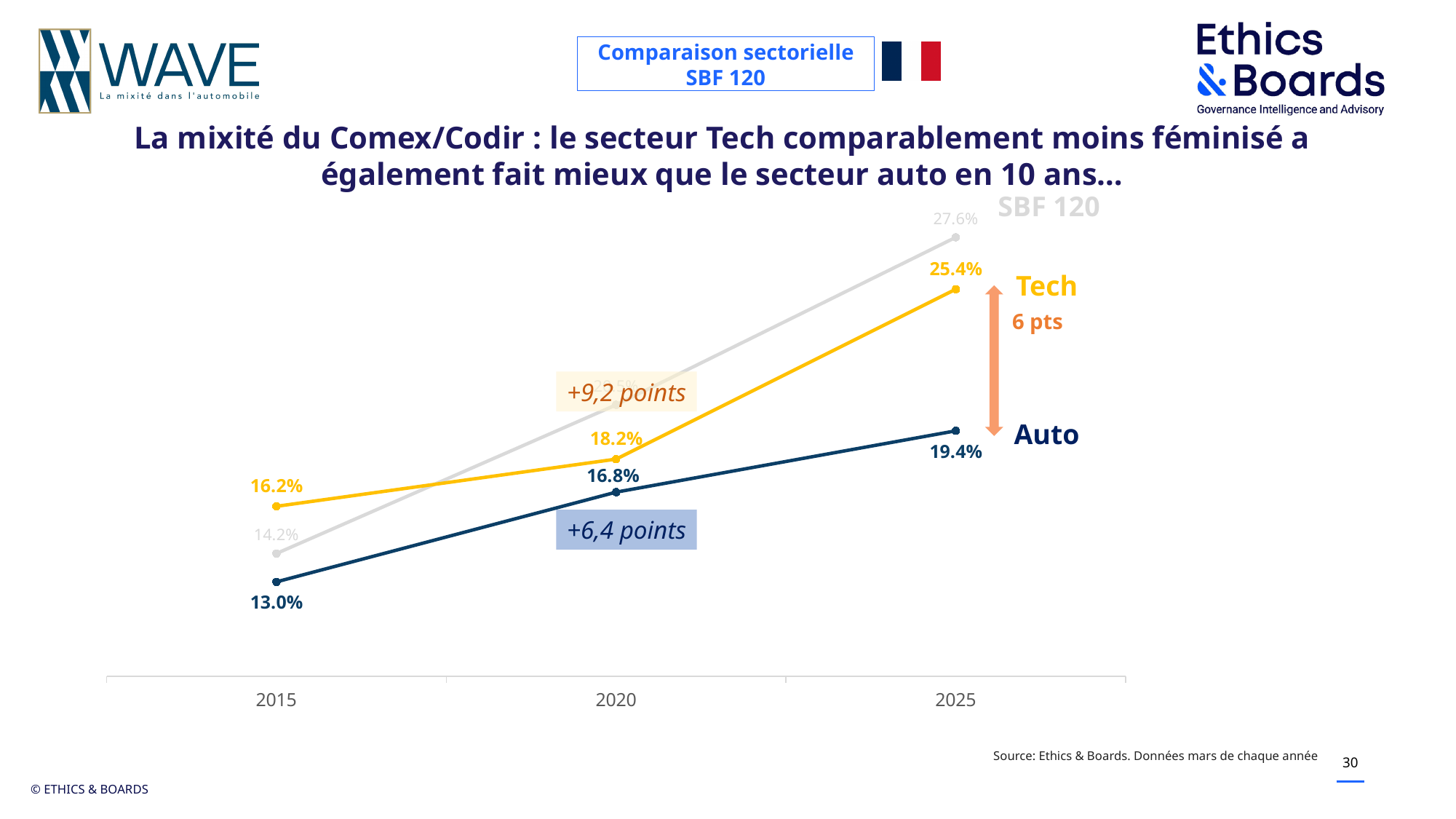
What is the value for the Tech series in 2025? 25.4% Which series has the highest value in 2025? SBF 120 What is the value for the SBF 120 series in 2025? 27.6% What is the value for the SBF 120 series in 2015? 14.2% Which series has the lowest value in 2015? Auto What kind of chart is shown on the slide? Line chart What is the value for the Auto series in 2015? 13.0% What is the value for the Auto series in 2020? 16.8% Which series has the larger value in 2015, Tech or Auto? Tech How many years are shown on the x axis? 3 What is the value for the Tech series in 2020? 18.2% What is the difference between the Tech and Auto values in 2025? 6 points